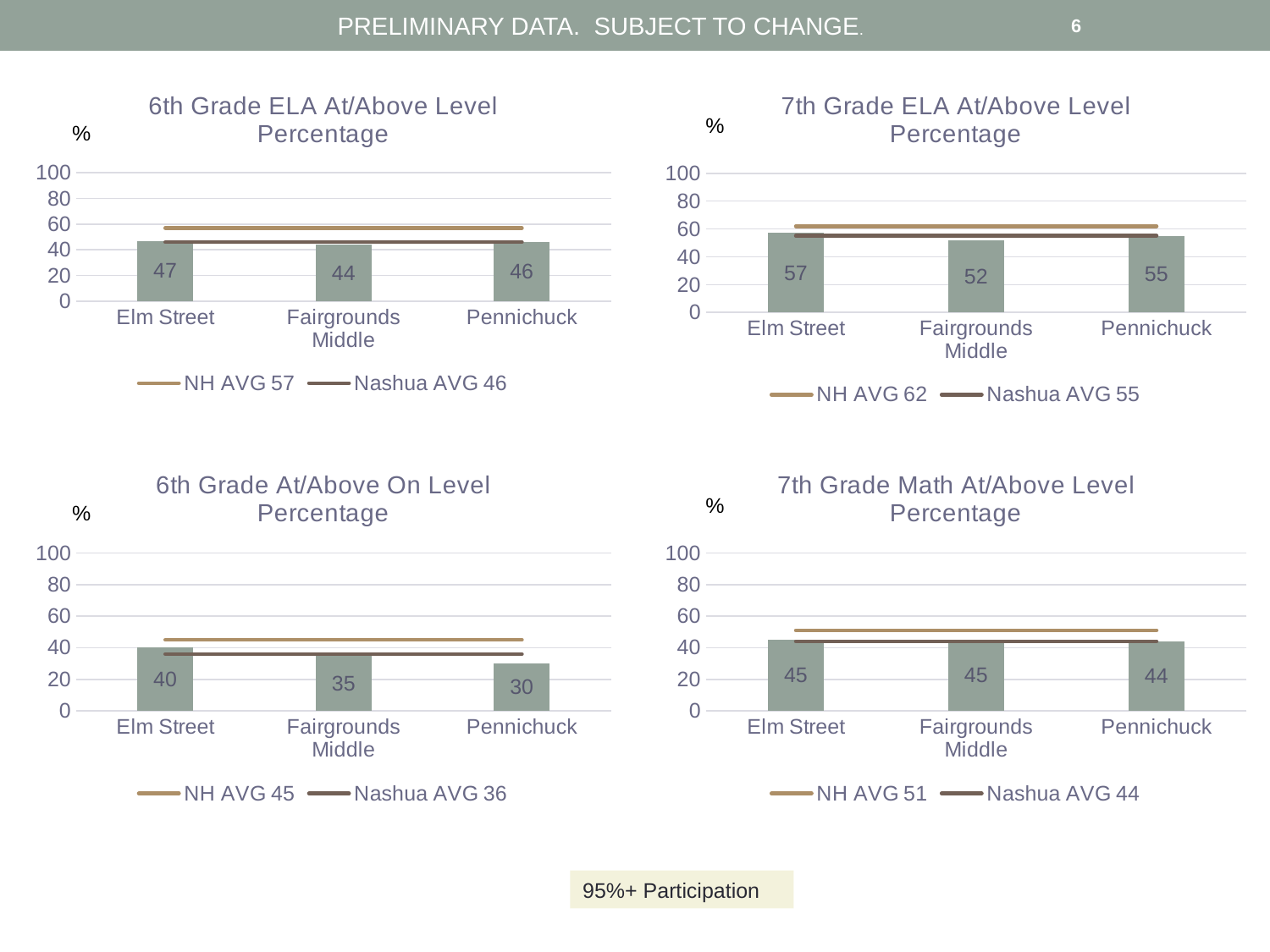
In the 6th Grade ELA At/Above Level Percentage chart, which school has the lowest value? Fairgrounds Middle In the 7th Grade Math At/Above Level Percentage chart, is the value for Elm Street greater or less than 60? less In the 7th Grade ELA At/Above Level Percentage chart, which school has the highest value? Elm Street In the 7th Grade ELA At/Above Level Percentage chart, what is the value for Pennichuck? 55 In the 6th Grade ELA At/Above Level Percentage chart, what is the value for Elm Street? 47 How many schools are shown in the 6th Grade ELA At/Above Level Percentage chart? 3 In the 6th Grade At/Above On Level Percentage chart, what is the value for Pennichuck? 30 In the 7th Grade ELA At/Above Level Percentage chart, what is the difference between Elm Street and Fairgrounds Middle? 5 In the 6th Grade At/Above On Level Percentage chart, do the values rise or fall from Elm Street to Pennichuck? fall In the 7th Grade Math At/Above Level Percentage chart, what is the value for Fairgrounds Middle? 45 What kind of chart is the 7th Grade Math At/Above Level Percentage chart? bar chart In the 6th Grade At/Above On Level Percentage chart, what is the difference between Elm Street and Pennichuck? 10